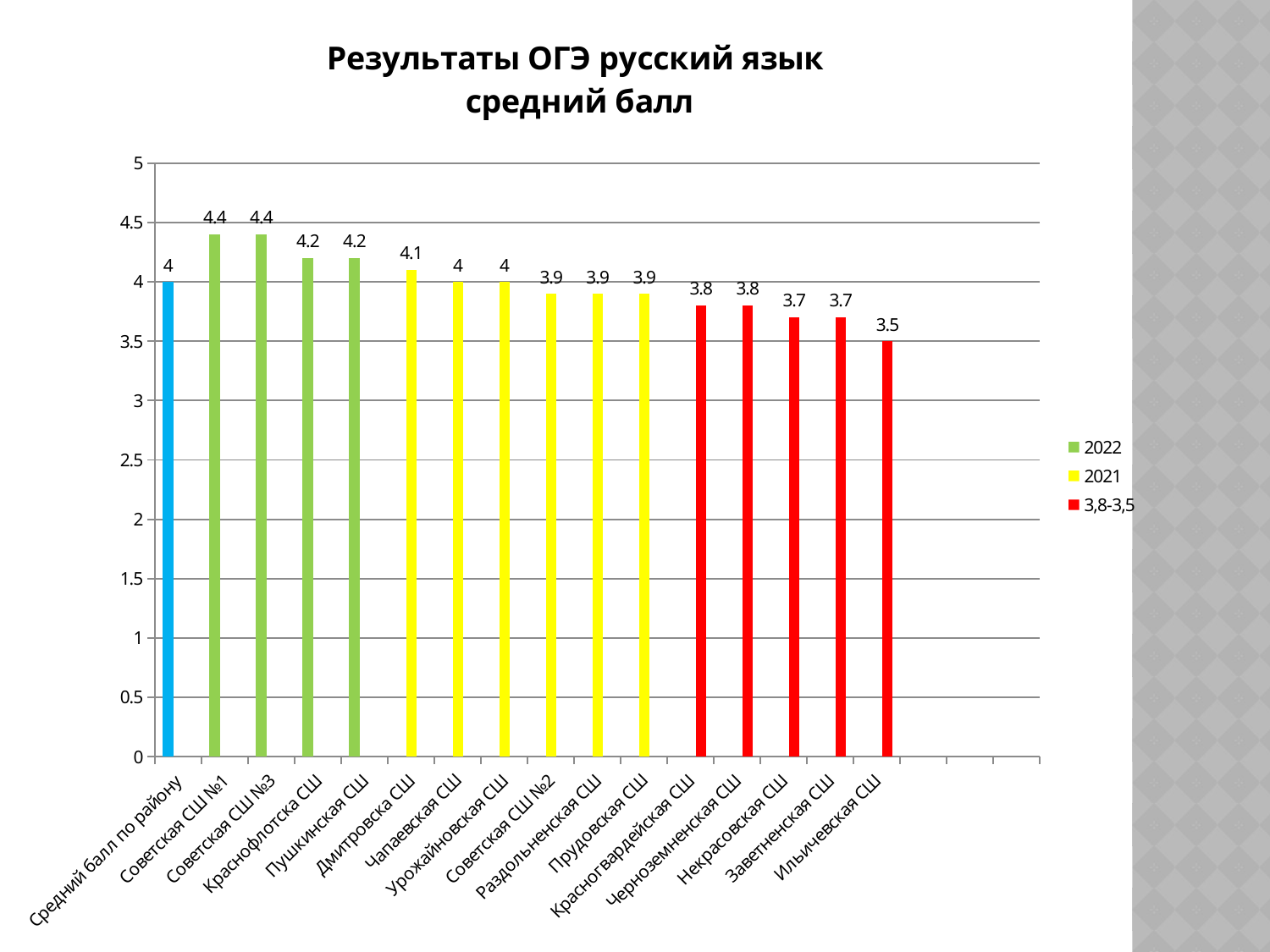
What is the value for Ильичевская СШ? 3.5 Which is larger, the value for Пушкинская СШ or the value for Черноземненская СШ? Пушкинская СШ How many categories are shown on the x axis? 16 What is the value for Некрасовская СШ? 3.7 What is the difference between the values for Советская СШ №1 and Ильичевская СШ? 0.9 What is the title of the chart? Результаты ОГЭ русский язык средний балл What is the value for Дмитровска СШ? 4.1 Which category has the lowest value? Ильичевская СШ What kind of chart is shown on the slide? bar chart How many entries does the legend list? 3 What is the value for Средний балл по району? 4 What is the difference between the values for Краснофлотска СШ and Прудовская СШ? 0.3